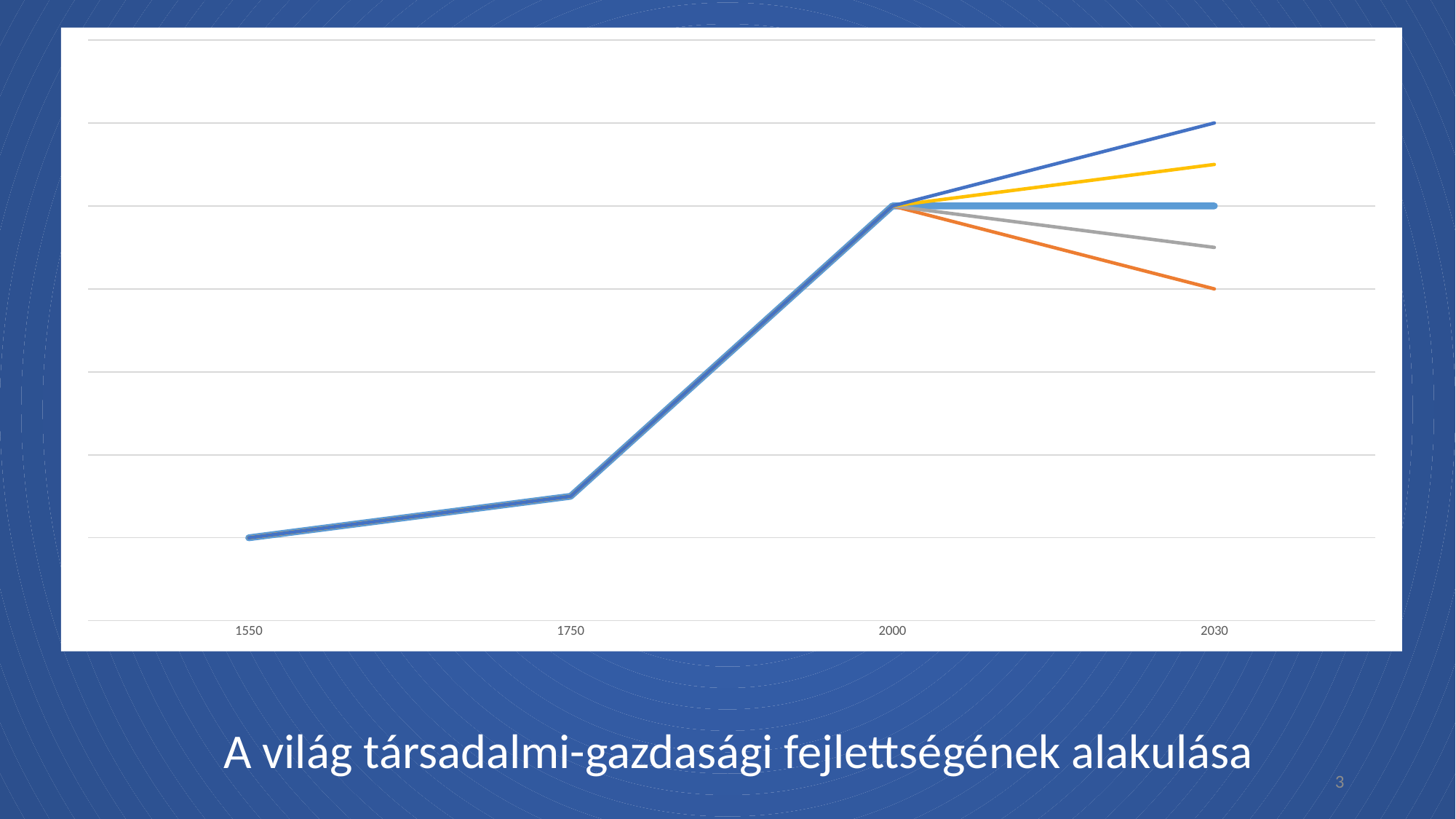
Does the yellow line rise or fall between 2000 and 2030? rise Which coloured line is lowest at 2030? orange What is the title text shown below the chart? A világ társadalmi-gazdasági fejlettségének alakulása What is the last year label on the x axis of the chart? 2030 What is the first year label on the x axis of the chart? 1550 Between which two x-axis labels does the line rise most steeply? 1750 and 2000 Does the plotted line rise or fall between 1550 and 2000? rise How many labels are shown on the x axis of the chart? 4 What kind of chart is shown on the slide? line chart Which coloured line is highest at 2030? dark blue Into how many separate lines does the chart branch after 2000? 5